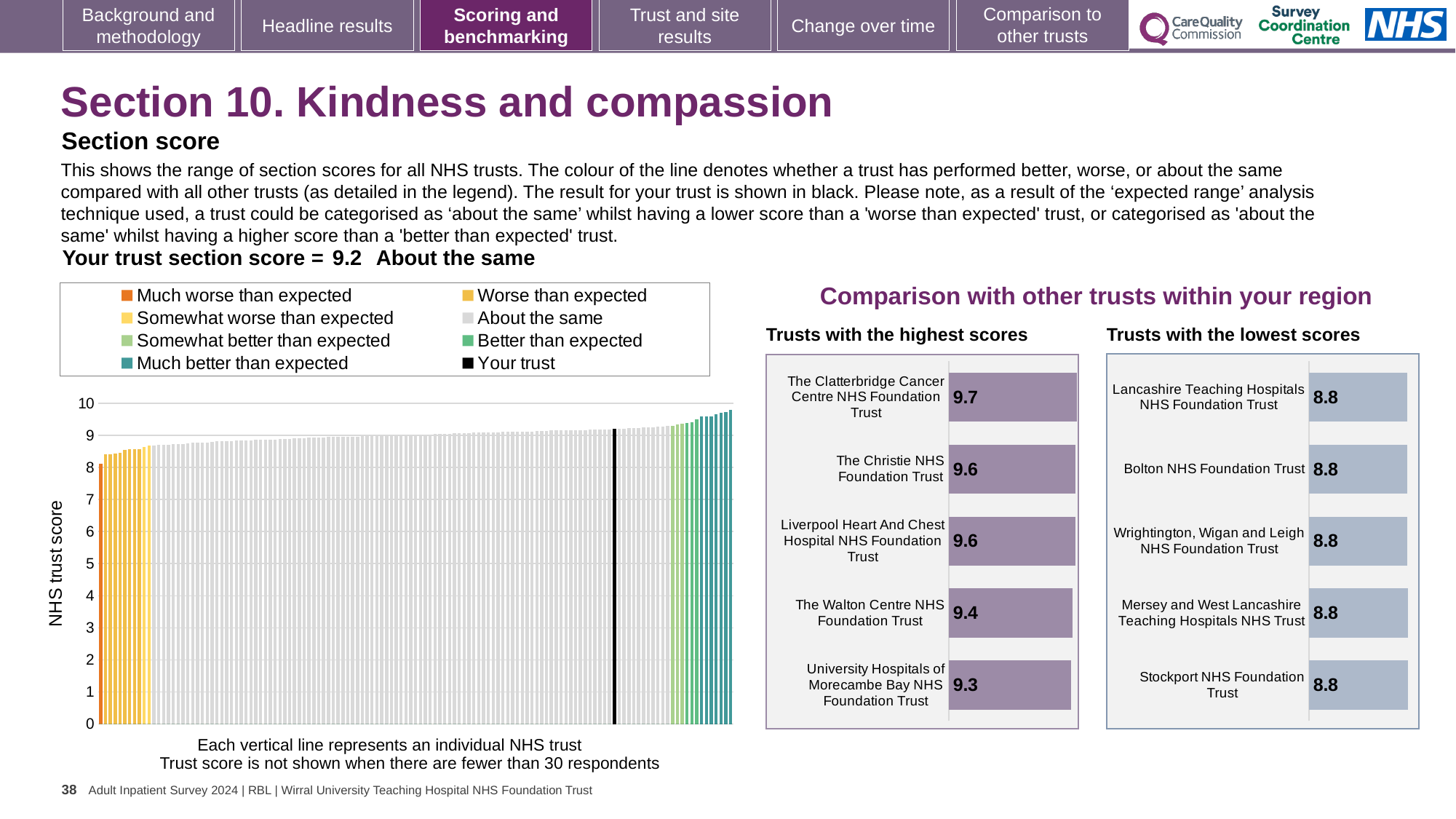
In the 'Trusts with the highest scores' chart, what is the score for The Clatterbridge Cancer Centre NHS Foundation Trust? 9.7 In the 'Trusts with the highest scores' chart, which trust has the lowest score? University Hospitals of Morecambe Bay NHS Foundation Trust In the 'Trusts with the lowest scores' chart, what is the score for Stockport NHS Foundation Trust? 8.8 What is the section score for your trust shown in the main NHS trust score chart? 9.2 In the 'Trusts with the highest scores' chart, what is the score for The Walton Centre NHS Foundation Trust? 9.4 In the 'Trusts with the highest scores' chart, which has the larger score: The Christie NHS Foundation Trust or The Walton Centre NHS Foundation Trust? The Christie NHS Foundation Trust In the 'Trusts with the highest scores' chart, what is the difference between the scores of The Clatterbridge Cancer Centre NHS Foundation Trust and University Hospitals of Morecambe Bay NHS Foundation Trust? 0.4 How many entries does the legend of the main 'NHS trust score' chart list? 8 How many trusts are shown in the 'Trusts with the lowest scores' chart? 5 What kind of chart is the main 'NHS trust score' chart on the left of the slide? Bar chart In the main 'NHS trust score' chart, do the trust scores rise or fall from left to right? Rise In the 'Trusts with the highest scores' chart, which trust has the highest score? The Clatterbridge Cancer Centre NHS Foundation Trust